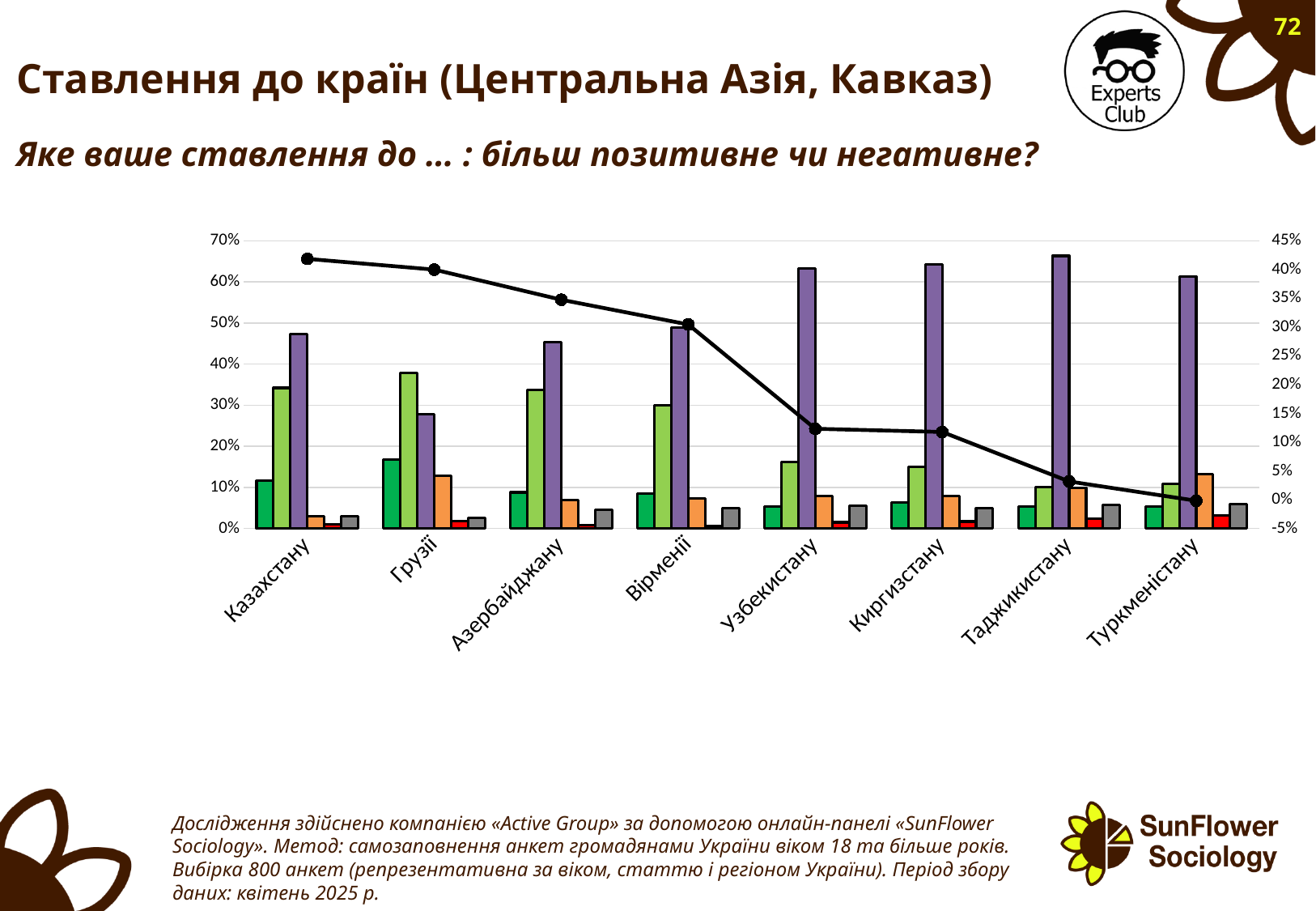
Is the black line value for Туркменістану (right axis) greater or less than 5%? less Does the black line rise or fall from Казахстану on the left to Туркменістану on the right? It falls Which country has the tallest dark green bar? Грузії What is the highest value shown on the right-hand vertical axis? 45% Is the purple bar for Таджикистану greater or less than 60%? greater Which country has the tallest light green bar? Грузії What kind of chart is shown on the slide? A bar chart combined with a line How many countries (categories) are shown on the x axis of the chart? 8 Which country has the lowest purple bar? Грузії Is the purple bar for Грузії greater or less than 30%? less Which has the larger purple bar, Казахстану or Грузії? Казахстану